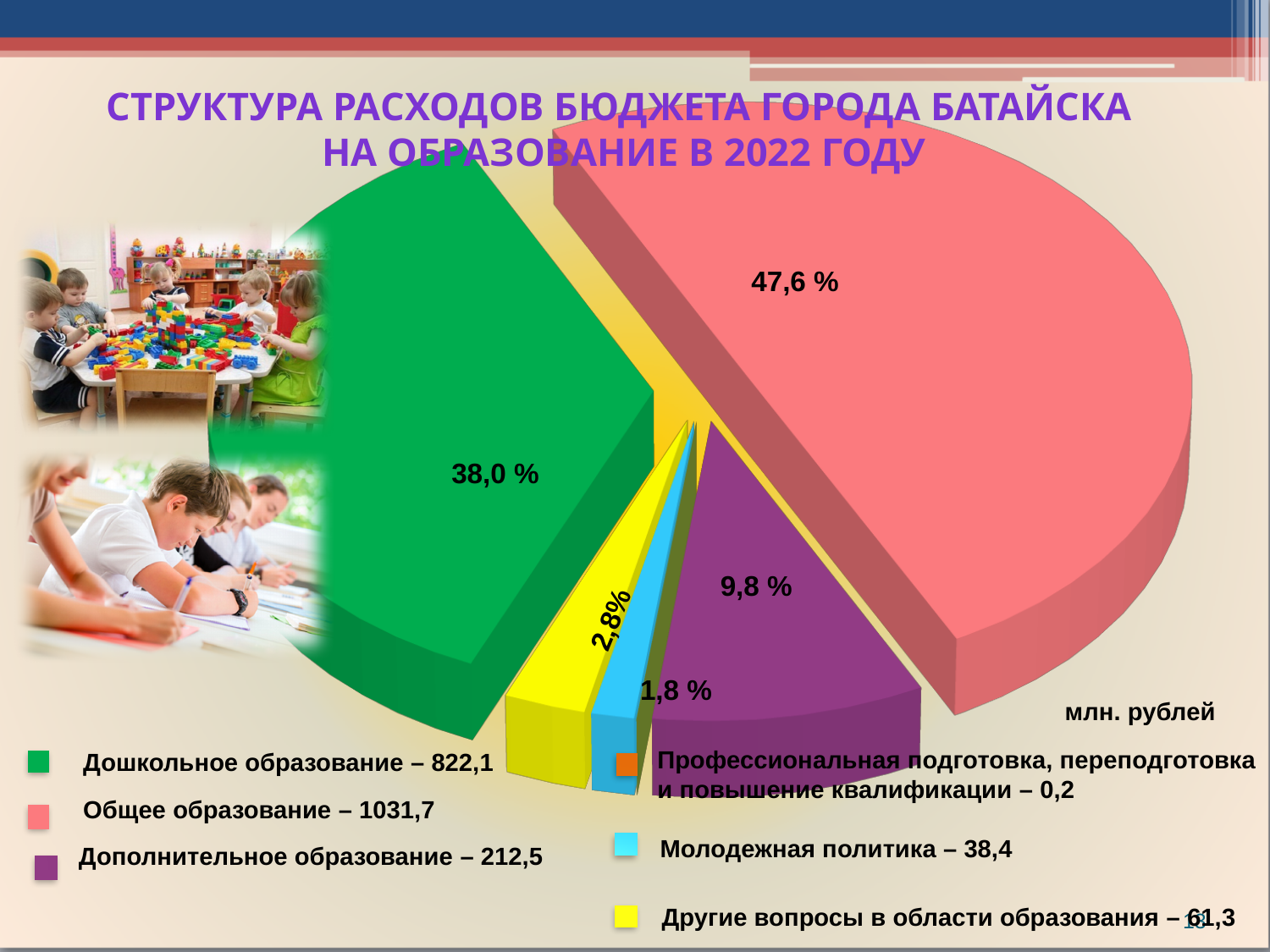
How many categories does the legend list? 6 What is the difference in млн. рублей between Общее образование and Дошкольное образование? 209,6 What type of chart is shown on the slide? Pie chart What share of the pie does Дополнительное образование account for? 9,8 % What amount (in млн. рублей) is listed for Молодежная политика? 38,4 Which category has the largest slice of the pie? Общее образование What share of the pie does Дошкольное образование account for? 38,0 % What colour is the slice for Дошкольное образование? Green Which is larger: the value for Дополнительное образование or for Молодежная политика? Дополнительное образование What amount (in млн. рублей) is listed for Дошкольное образование? 822,1 Which category has the smallest value in the legend? Профессиональная подготовка, переподготовка и повышение квалификации What share of the pie does Общее образование account for? 47,6 %